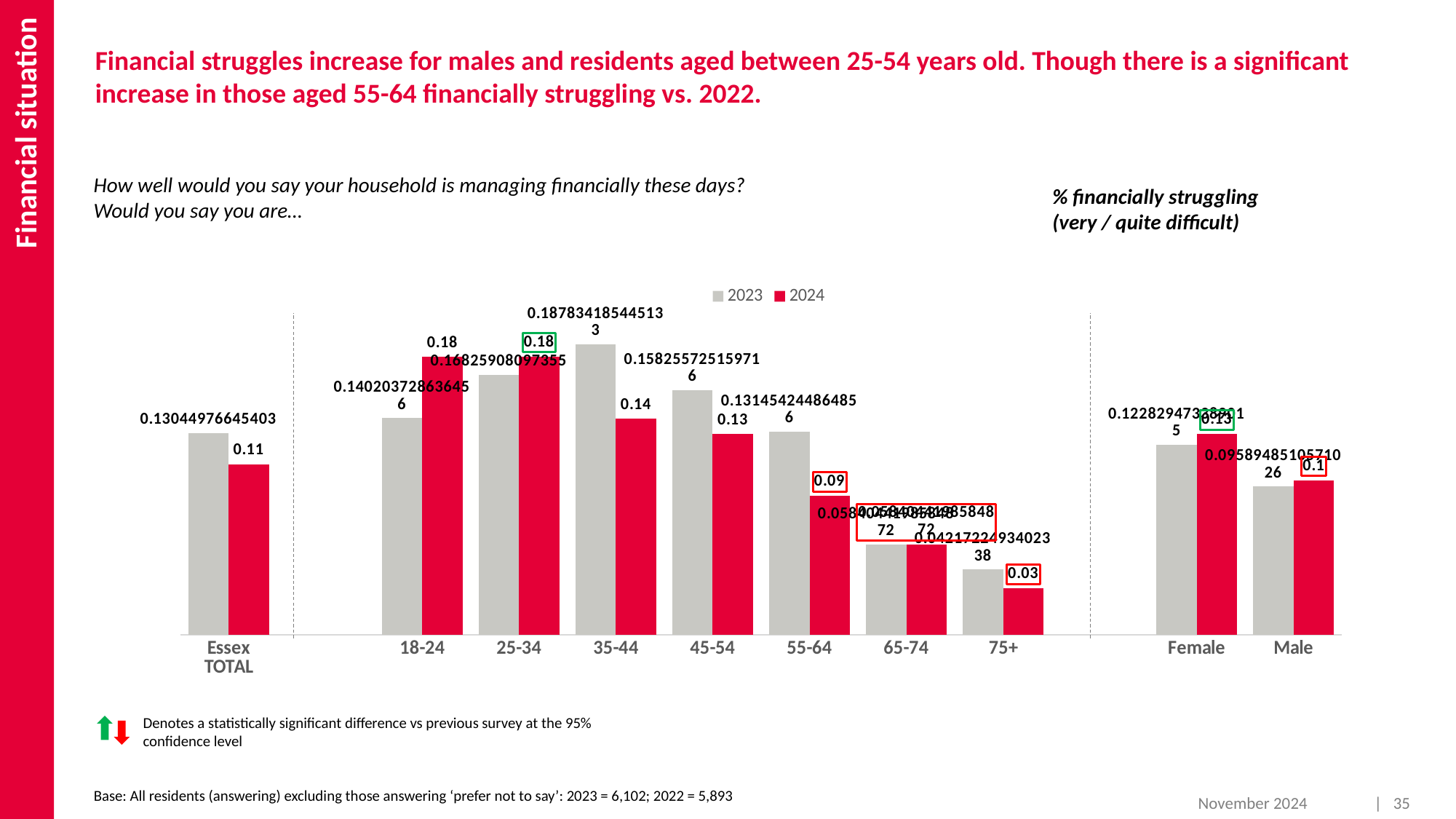
What is the 2024 value for Male? 0.1 What is the 2023 value for Essex TOTAL? 0.13044976645403 What is the 2024 value for Essex TOTAL? 0.11 What are the two series named in the legend? 2023 and 2024 Do the 2024 values rise or fall across the age groups from 18-24 to 75+? fall What is the 2024 value for the 55-64 age group? 0.09 How many series does the legend list? 2 What is the difference between the 2024 values for 18-24 and 75+? 0.15 How many categories are shown along the x axis? 10 What kind of chart is shown on the slide? bar chart Which is larger for Essex TOTAL, the 2023 value or the 2024 value? 2023 Which category has the lowest 2024 value? 75+